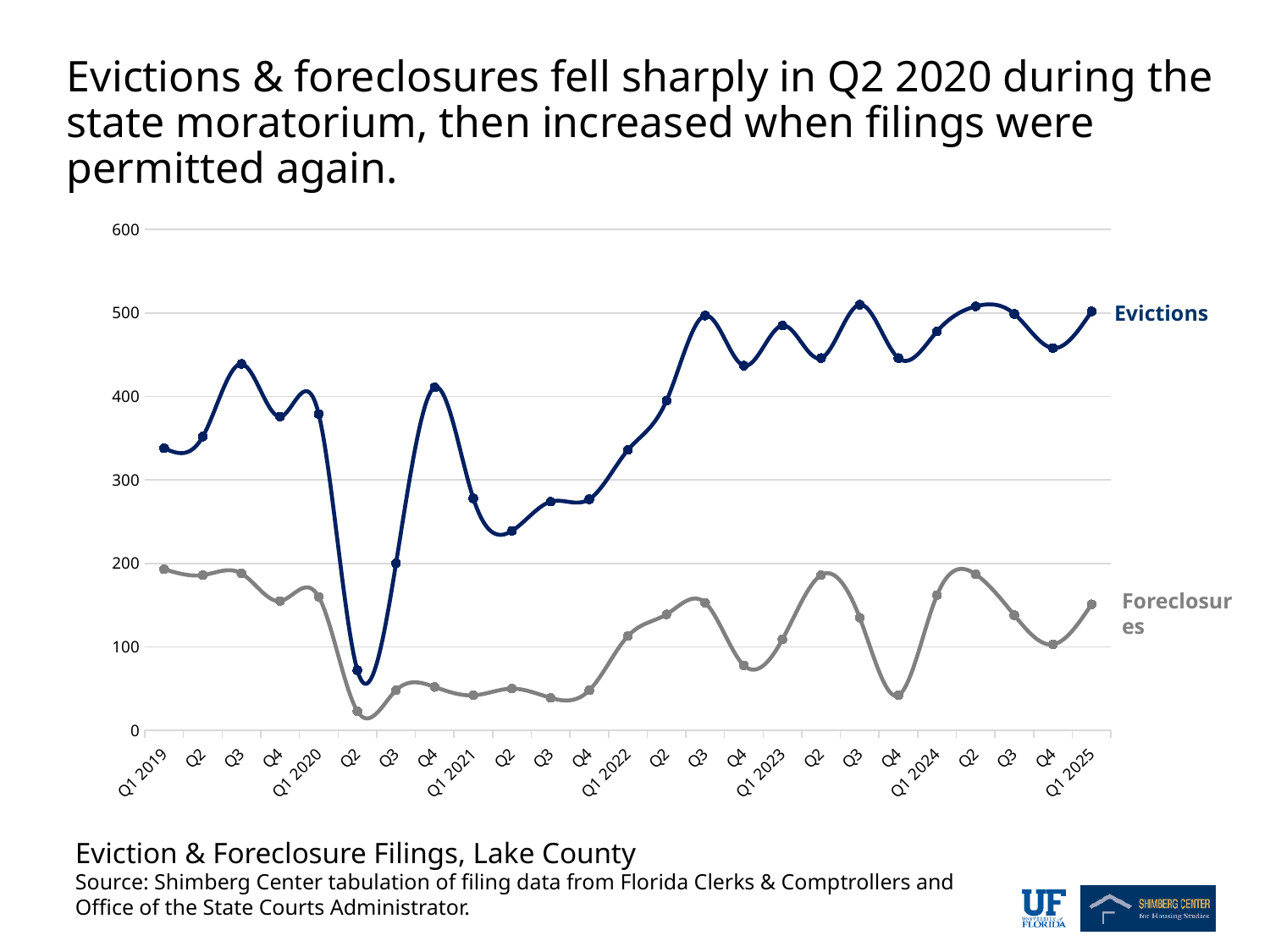
How many series are plotted on the chart? 2 Which is larger in Q1 2019, Evictions or Foreclosures? Evictions In which quarter is the Foreclosures line at its lowest? Q2 2020 How many quarterly data points does each line have, from Q1 2019 to Q1 2025? 25 Is the value for Evictions in Q3 2022 greater or less than 400? greater Is the value for Foreclosures in Q2 2023 greater or less than 100? greater In which quarter is the Evictions line at its lowest? Q2 2020 Do Evictions rise or fall between Q1 2021 and Q3 2022? Rise Is the value for Evictions in Q2 2020 greater or less than 100? less Which is larger for Evictions, the value in Q1 2019 or the value in Q1 2025? Q1 2025 What kind of chart is shown on the slide? Line chart